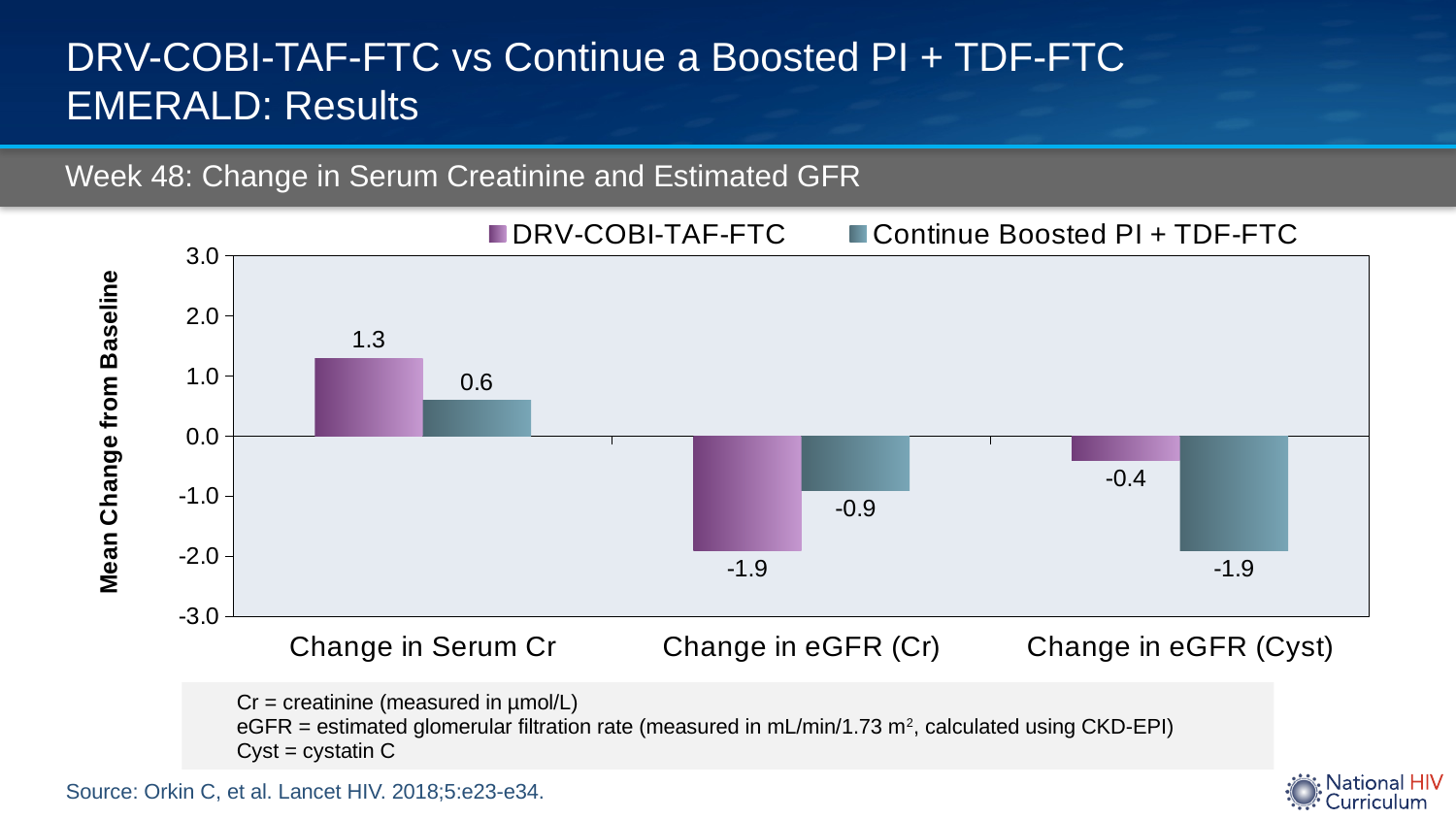
What is the mean change in serum Cr for Continue Boosted PI + TDF-FTC? 0.6 Which category has the highest value for DRV-COBI-TAF-FTC? Change in Serum Cr What is the mean change in serum Cr for DRV-COBI-TAF-FTC? 1.3 How many categories are shown on the x axis? 3 Which series has the larger change in serum Cr, DRV-COBI-TAF-FTC or Continue Boosted PI + TDF-FTC? DRV-COBI-TAF-FTC How many series does the legend list? 2 What is the difference between the DRV-COBI-TAF-FTC and Continue Boosted PI + TDF-FTC values for change in eGFR (Cr)? 1.0 What type of chart is shown on the slide? Bar chart What is the mean change in eGFR (Cyst) for Continue Boosted PI + TDF-FTC? -1.9 What is the mean change in eGFR (Cr) for DRV-COBI-TAF-FTC? -1.9 What is the difference between the DRV-COBI-TAF-FTC and Continue Boosted PI + TDF-FTC values for change in serum Cr? 0.7 What is the mean change in eGFR (Cyst) for DRV-COBI-TAF-FTC? -0.4